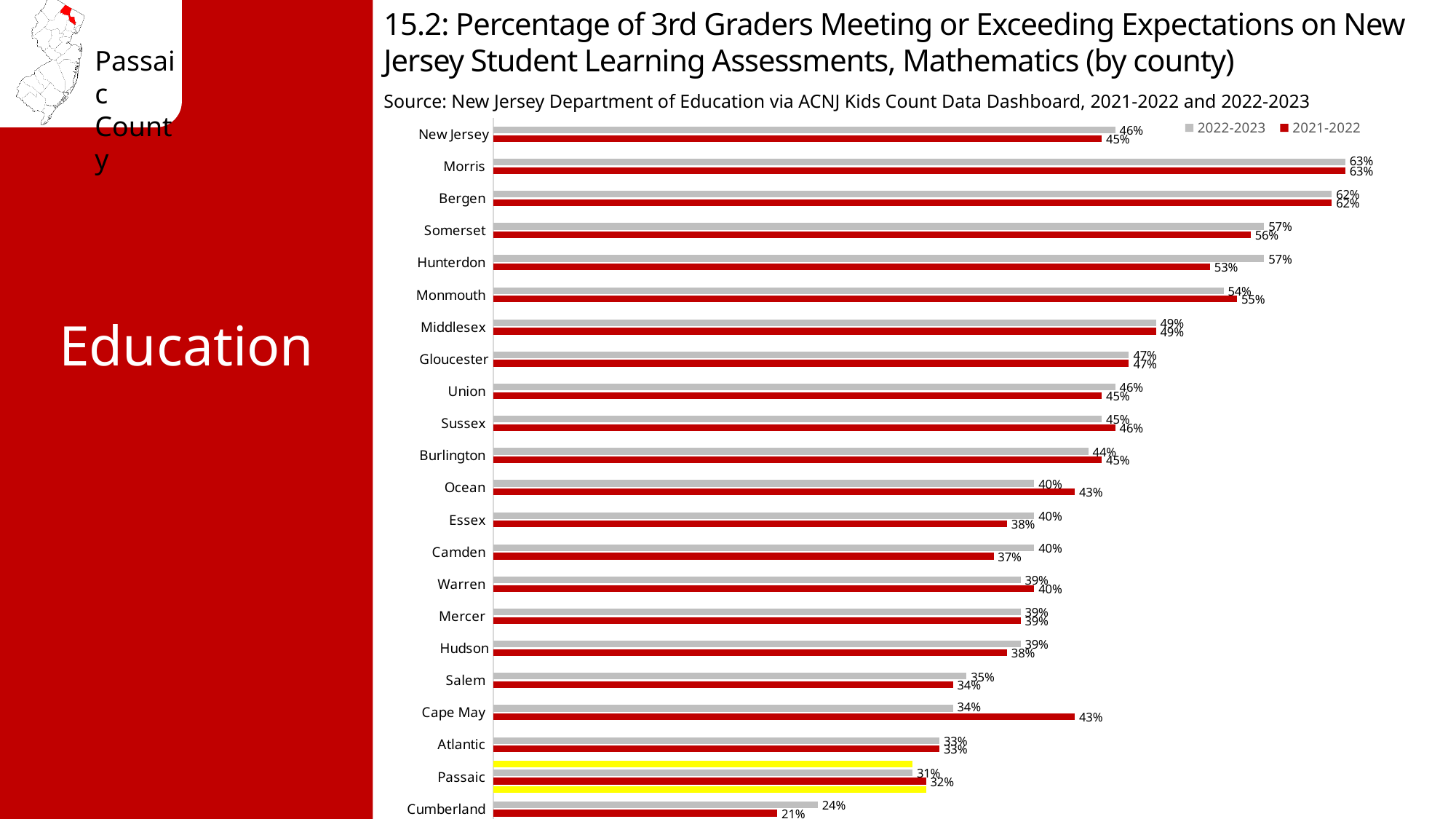
Which county's bars are highlighted in yellow on the chart? Passaic How many series does the legend list? 2 What is the difference between the 2022-2023 and 2021-2022 values for Cape May? 9% What is the difference between the 2022-2023 values for Morris and Cumberland? 39% What kind of chart is shown on the slide? Bar chart What is the 2022-2023 value for Passaic? 31% Which county has the lowest 2021-2022 value? Cumberland What is the 2021-2022 value for Cape May? 43% How many categories are shown on the chart? 22 Which is larger for Hunterdon: the 2022-2023 value or the 2021-2022 value? 2022-2023 Which county has the highest 2022-2023 value? Morris What is the 2022-2023 value for Hunterdon? 57%